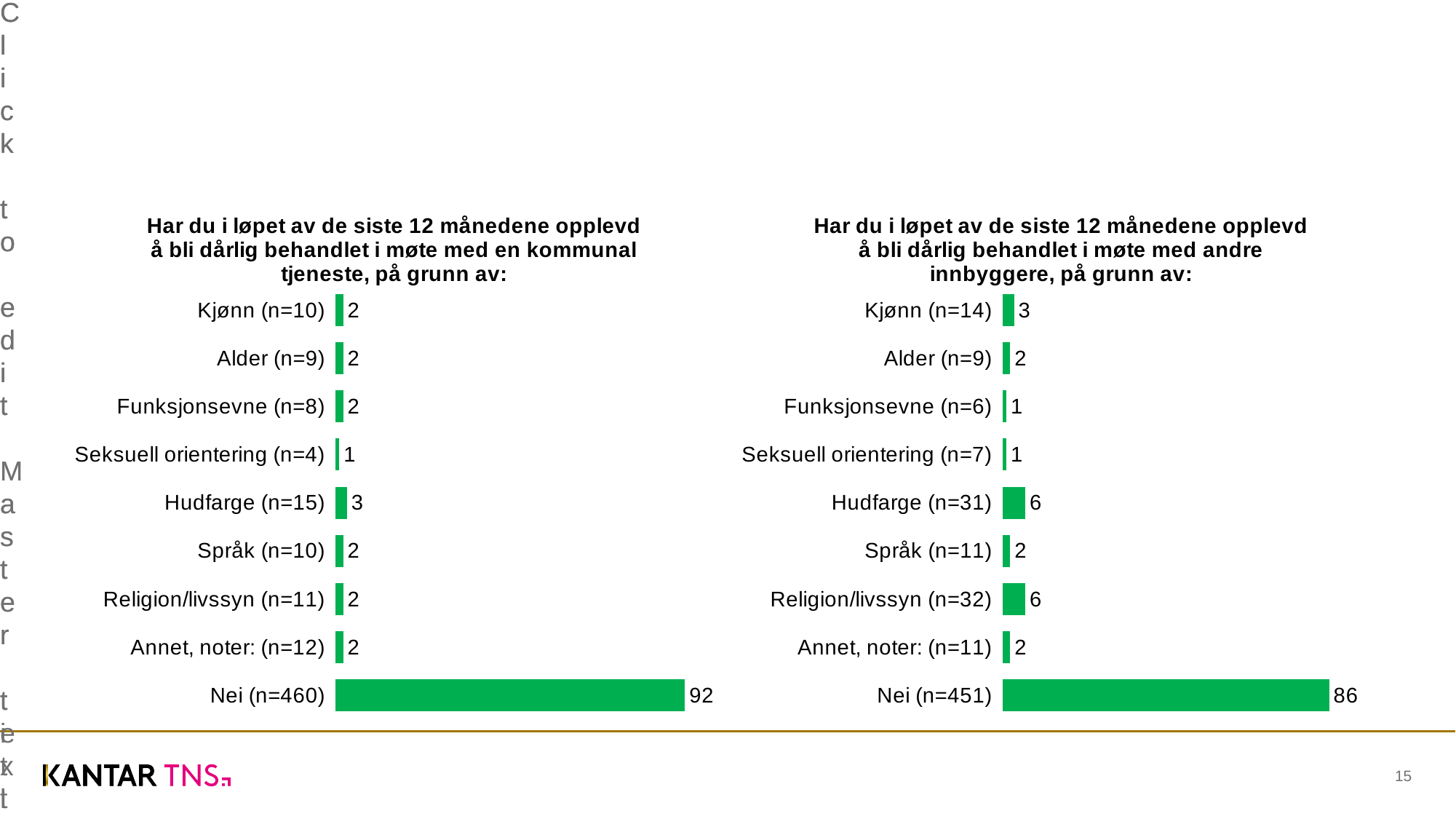
In the right chart (andre innbyggere), which category has the highest value? Nei (n=451) In the right chart (andre innbyggere), what is the value for Kjønn (n=14)? 3 How many categories are shown in the left chart (kommunal tjeneste)? 9 In the left chart (kommunal tjeneste), which category has the lowest value? Seksuell orientering (n=4) What colour are the bars in both charts? Green What is the difference between the Nei value in the left chart (92) and the Nei value in the right chart (86)? 6 In the left chart (kommunal tjeneste), what is the value for Nei (n=460)? 92 Which is larger: Hudfarge in the left chart (kommunal tjeneste) or Hudfarge in the right chart (andre innbyggere)? Hudfarge in the right chart In the right chart (andre innbyggere), what is the value for Hudfarge (n=31)? 6 In the left chart (kommunal tjeneste), what is the value for Hudfarge (n=15)? 3 What type of chart is the right chart (andre innbyggere)? Bar chart In the right chart (andre innbyggere), what is the difference between Religion/livssyn (n=32) and Alder (n=9)? 4